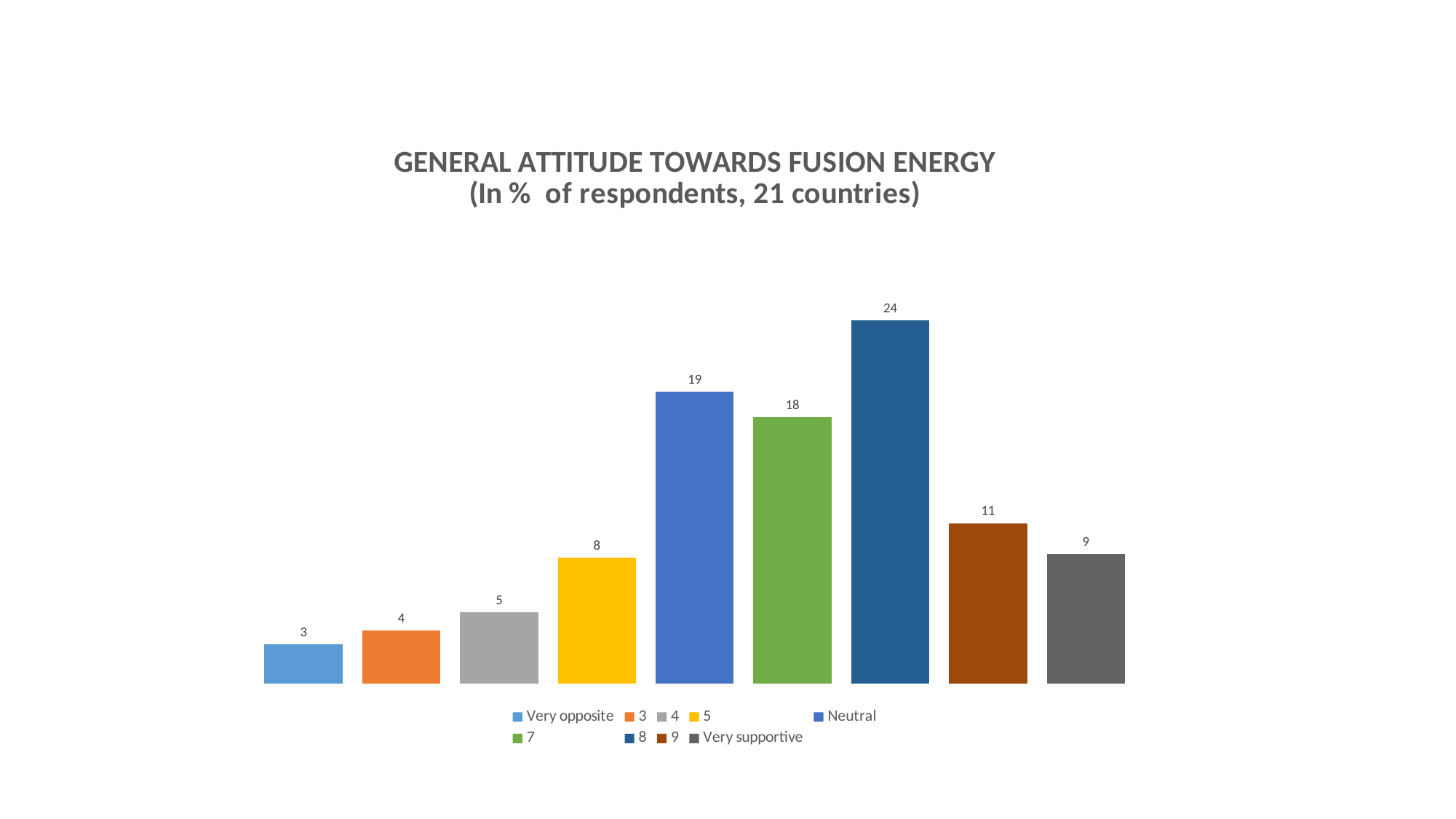
What type of chart is shown on the slide? Bar chart What is the value for the 'Neutral' bar? 19 Which is larger, the value for '9' or the value for 'Very supportive'? 9 What is the value for the bar labelled '8'? 24 What is the value for the 'Very supportive' bar? 9 Which category has the highest value? 8 How many entries does the legend list? 9 What is the value for the 'Very opposite' bar? 3 What is the difference between the value for '8' and the value for 'Neutral'? 5 How many bars are plotted in the chart? 9 Which category has the lowest value? Very opposite What is the title of the chart? GENERAL ATTITUDE TOWARDS FUSION ENERGY (In % of respondents, 21 countries)